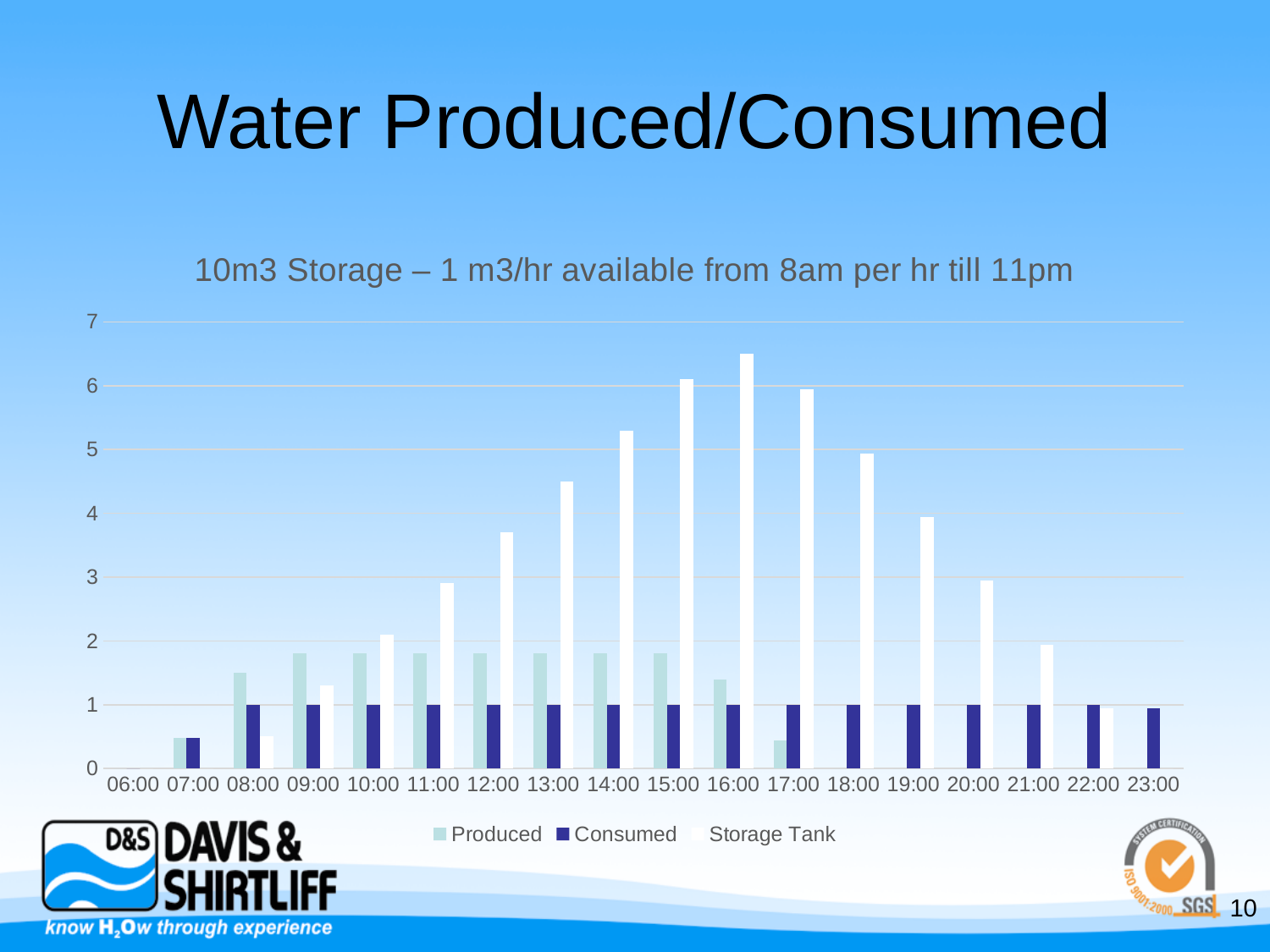
Which is larger, the Storage Tank value at 15:00 or at 18:00? 15:00 At which time is the Storage Tank value highest? 16:00 How many time categories are shown on the x axis? 18 What are the three legend entries of the chart? Produced, Consumed, Storage Tank What kind of chart is shown on the slide? bar chart What is the Consumed value at 12:00? 1 Is the Storage Tank value at 16:00 greater or less than 6? greater How many series does the legend list? 3 At 10:00, which is larger, Produced or Storage Tank? Storage Tank Does the Storage Tank value rise or fall from 16:00 to 23:00? fall Is the Storage Tank value at 12:00 greater or less than 4? less Is the Storage Tank value at 14:00 greater or less than 5? greater